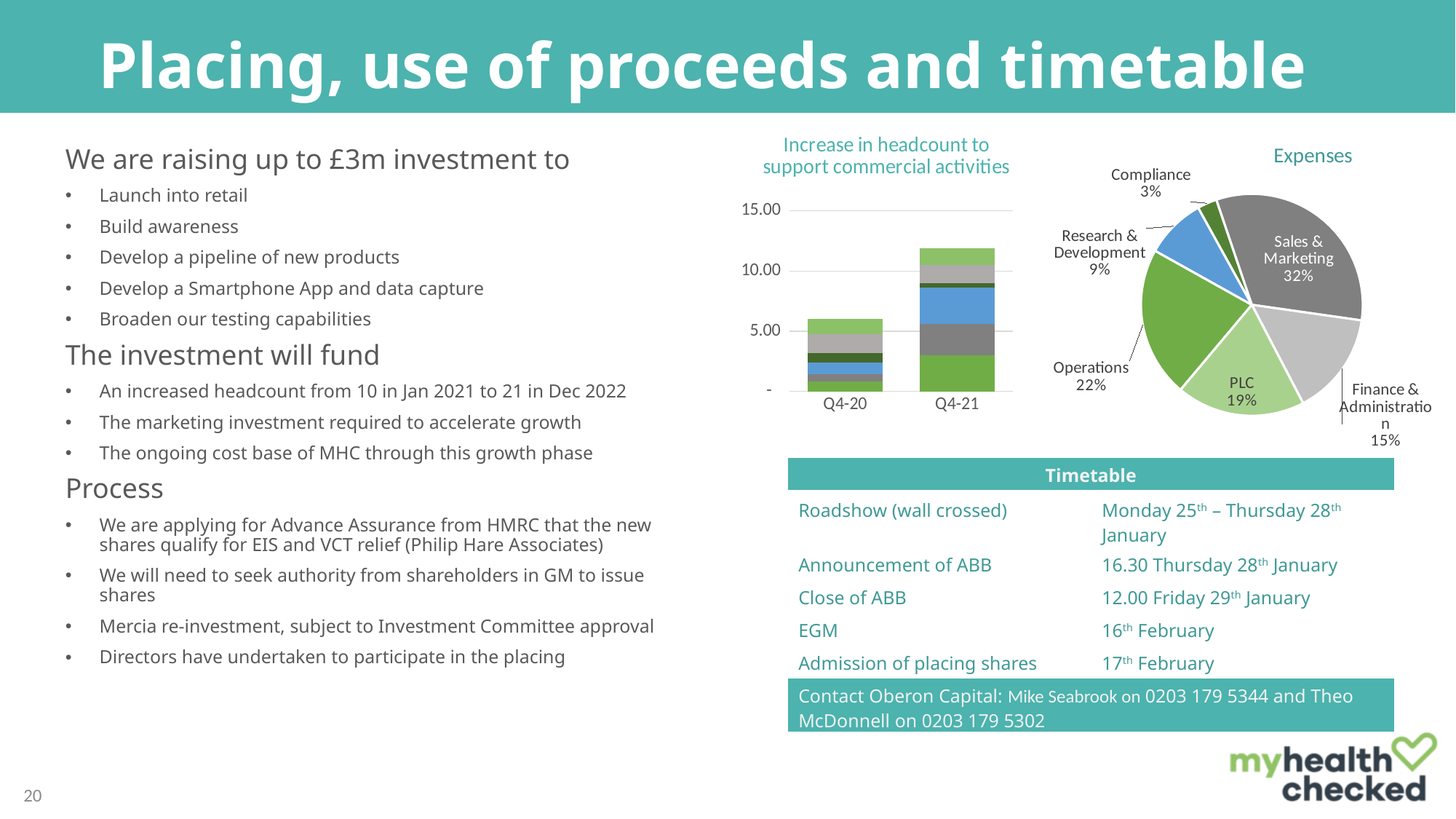
In the Expenses pie chart, what percentage is shown for Finance & Administration? 15% In the Expenses pie chart, which category has the smallest share? Compliance In the Expenses pie chart, which category has the largest share? Sales & Marketing How many slices does the Expenses pie chart have? 6 What type of chart is the 'Increase in headcount to support commercial activities' chart? Stacked bar chart How many categories are shown on the x axis of the 'Increase in headcount to support commercial activities' chart? 2 In the 'Increase in headcount to support commercial activities' chart, is the total for Q4-20 greater or less than 10.00? less In the Expenses pie chart, what is the difference in percentage points between Sales & Marketing and Operations? 10 percentage points In the Expenses pie chart, what percentage is shown for Operations? 22% In the 'Increase in headcount to support commercial activities' chart, is the total for Q4-21 greater or less than 10.00? greater In the Expenses pie chart, which is larger: Operations or PLC? Operations In the Expenses pie chart, what share of expenses is Sales & Marketing? 32%